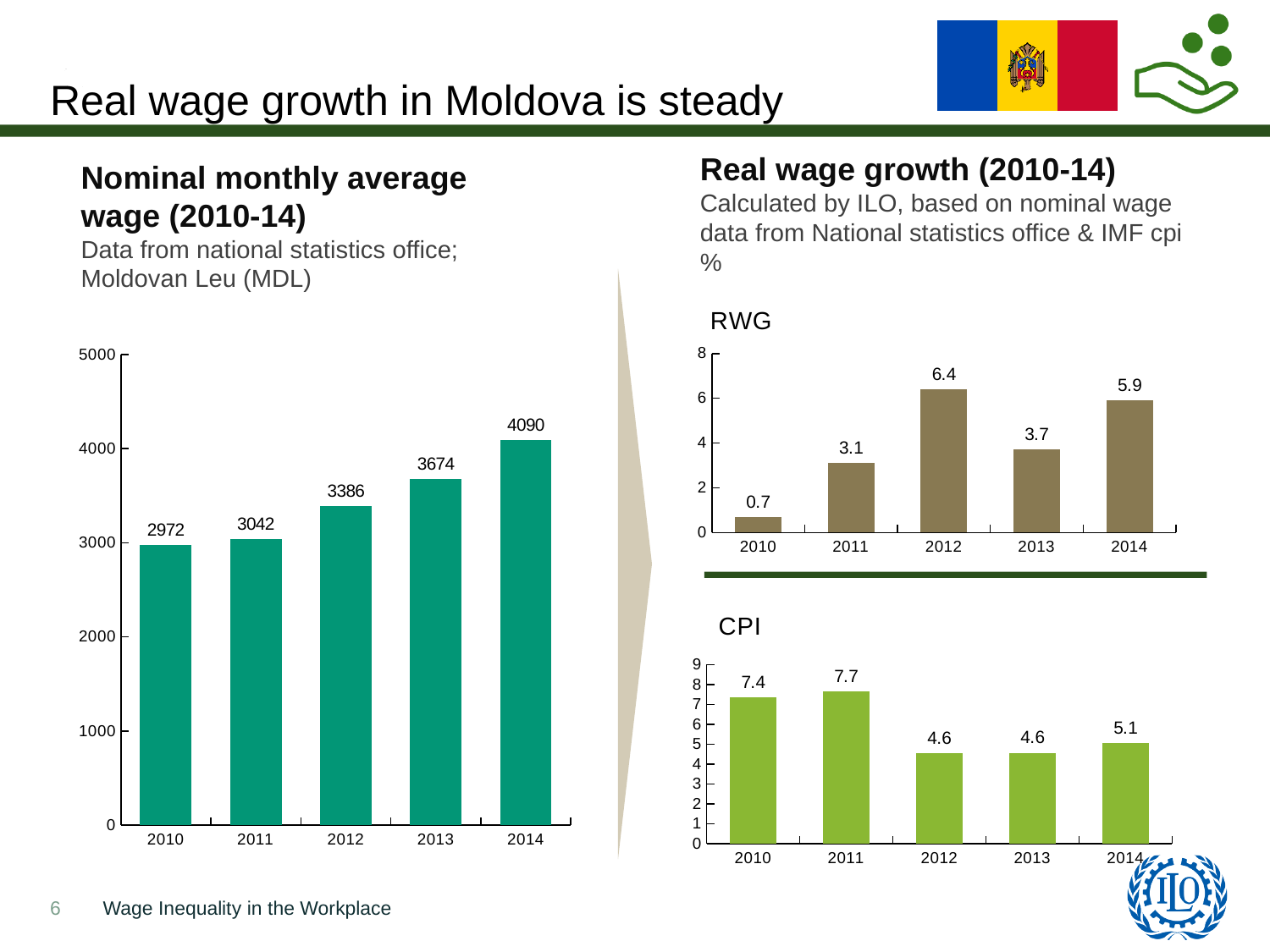
In the Nominal monthly average wage chart, which year has the highest value? 2014 In the RWG chart, which is larger, the value for 2012 or the value for 2014? 2012 In the RWG chart, what is the value for 2013? 3.7 In the RWG chart, which year has the lowest value? 2010 In the CPI chart, what is the value for 2011? 7.7 In the CPI chart, which year has the highest value? 2011 In the Nominal monthly average wage chart, what is the difference between the 2014 and 2010 values? 1118 In the Nominal monthly average wage chart, how many years are plotted? 5 What kind of chart is the CPI chart? bar chart In the CPI chart, what is the difference between the 2010 and 2012 values? 2.8 In the Nominal monthly average wage chart, do the values rise or fall from 2010 to 2014? rise In the Nominal monthly average wage chart, what is the value for 2012? 3386